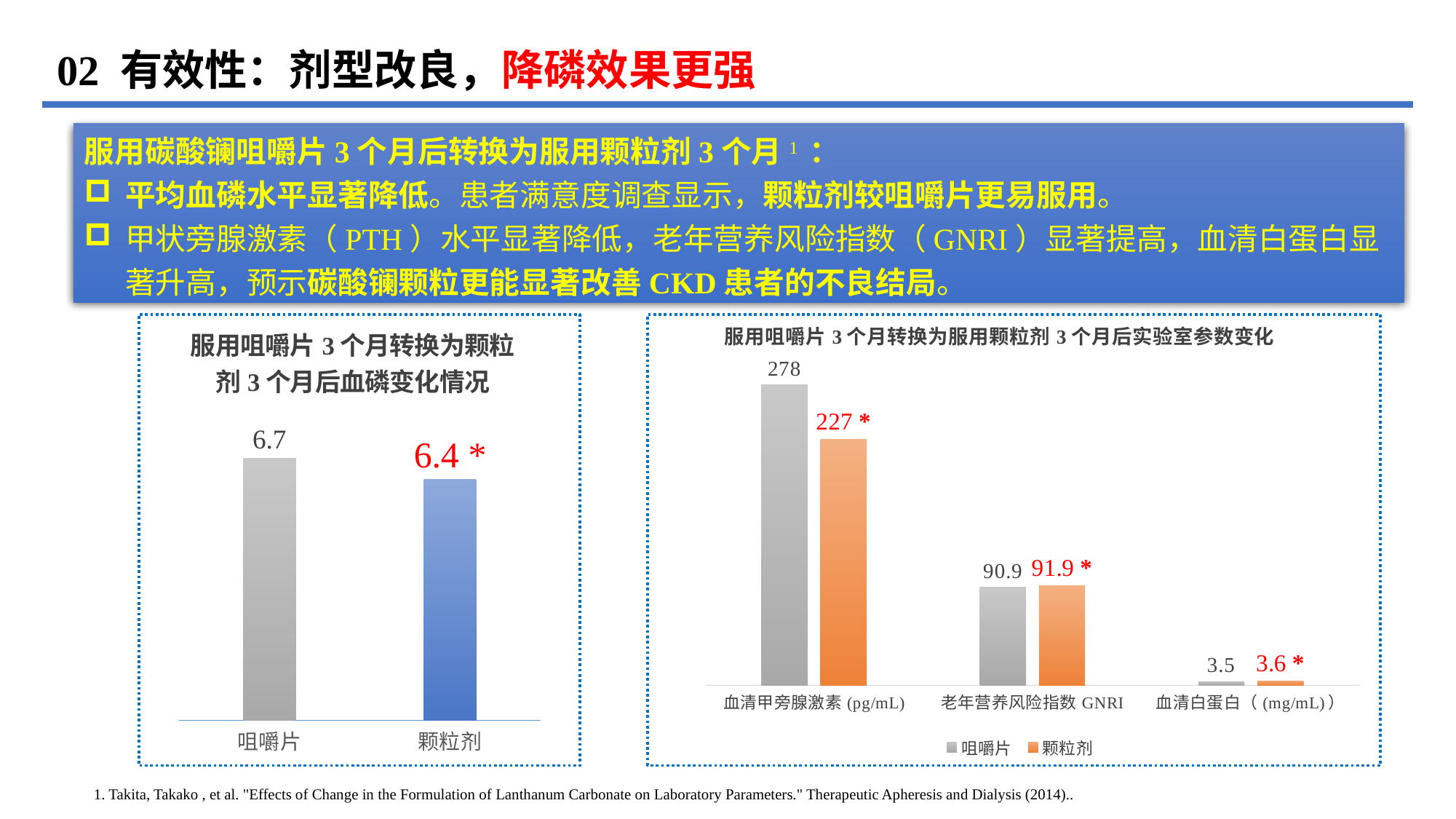
In the right chart (实验室参数变化), how many series does the legend list? 2 In the left chart (血磷变化情况), what is the difference between the 咀嚼片 value and the 颗粒剂 value? 0.3 In the right chart (实验室参数变化), how many categories are shown on the x axis? 3 In the right chart (实验室参数变化), what is the 咀嚼片 value for 血清白蛋白? 3.5 In the left chart (血磷变化情况), which category has the higher value, 咀嚼片 or 颗粒剂? 咀嚼片 In the right chart (实验室参数变化), what is the 颗粒剂 value for 血清甲旁腺激素 (pg/mL)? 227 In the left chart (血磷变化情况), what is the value for 咀嚼片? 6.7 In the right chart (实验室参数变化), what is the 颗粒剂 value for 老年营养风险指数 GNRI? 91.9 In the left chart (血磷变化情况), what is the value for 颗粒剂? 6.4 In the right chart (实验室参数变化), what is the difference between the 咀嚼片 and 颗粒剂 values for 血清甲旁腺激素 (pg/mL)? 51 In the right chart (实验室参数变化), what is the 咀嚼片 value for 血清甲旁腺激素 (pg/mL)? 278 What kind of chart is the left chart (血磷变化情况)? bar chart